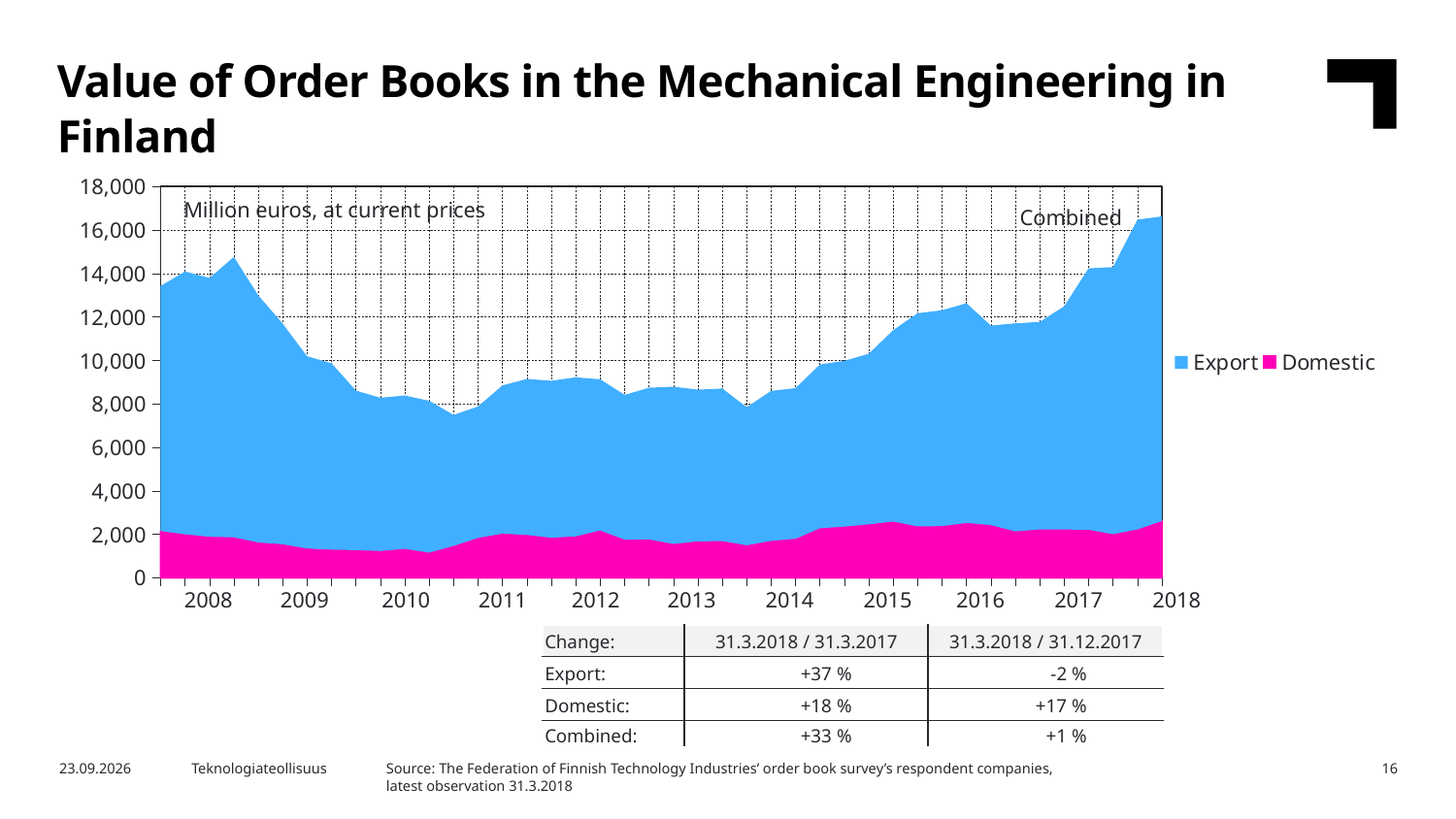
Is the combined value at the start of 2018 greater or less than 16,000? greater Which two series are listed in the chart legend? Export and Domestic How many year labels are shown on the x axis? 11 Is the combined value at the start of 2013 greater or less than 10,000? less Is the Domestic value at the start of 2018 greater or less than 2,000? greater How many series does the legend list? 2 What type of chart is shown on the slide? Stacked area chart What unit is stated in the chart's annotation? Million euros, at current prices In which year does the combined value reach its highest level? 2018 Does the combined value rise or fall between 2016 and 2018? rise